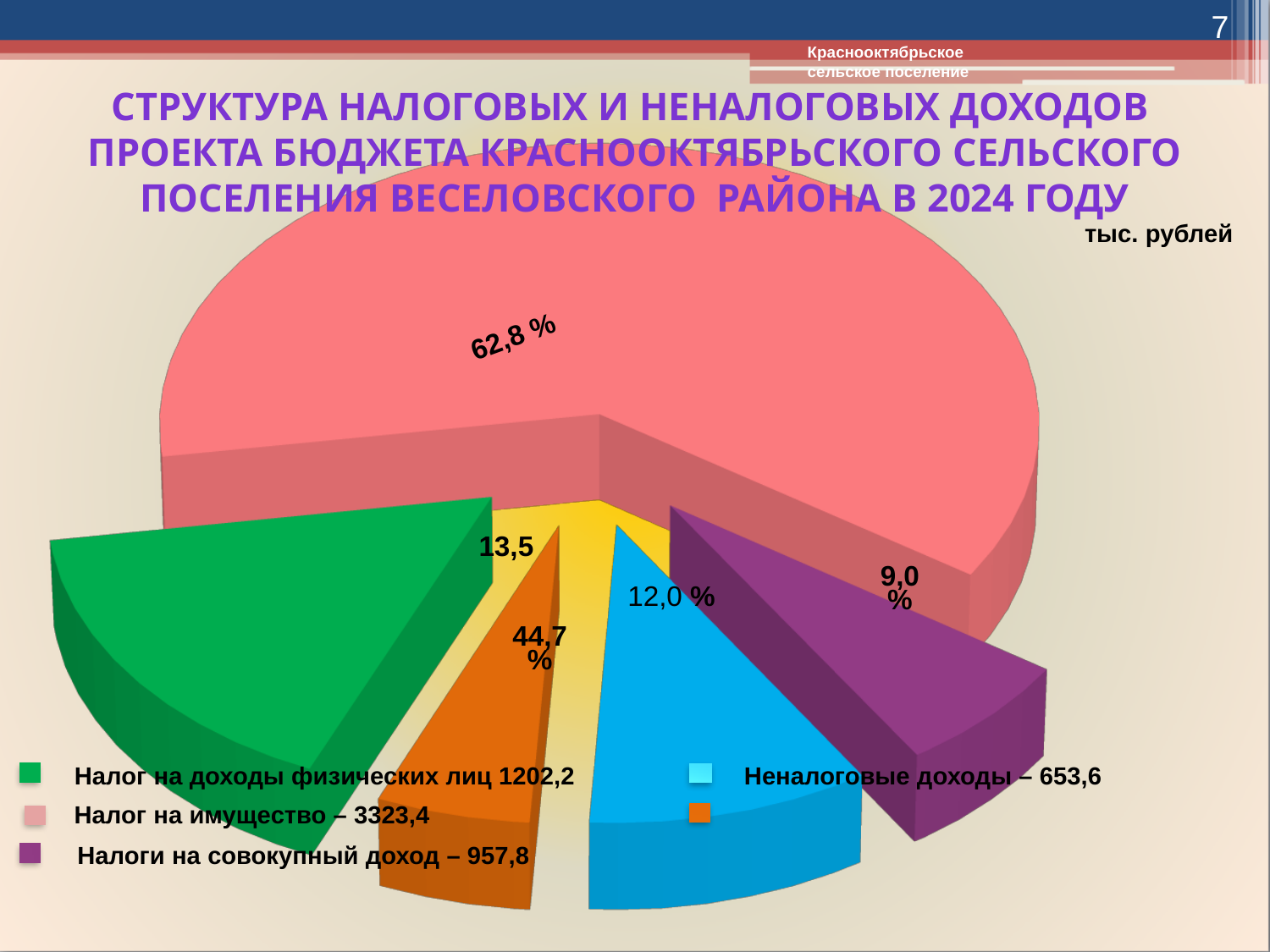
What is the difference between the values for Налоги на совокупный доход and Неналоговые доходы? 304,2 What is the difference between the values for Налог на имущество and Налог на доходы физических лиц? 2121,2 What value is given in the legend for Налог на доходы физических лиц? 1202,2 What kind of chart is shown on the slide? pie chart What value is given in the legend for Налоги на совокупный доход? 957,8 What share of the pie does Налог на имущество take? 62,8 % Which is larger: Налог на доходы физических лиц or Неналоговые доходы? Налог на доходы физических лиц What value is given in the legend for Налог на имущество? 3323,4 In what units are the values on the chart given? тыс. рублей Which category has the largest slice of the pie? Налог на имущество What value is given in the legend for Неналоговые доходы? 653,6 What percentage label is shown on the purple slice (Налоги на совокупный доход)? 9,0 %